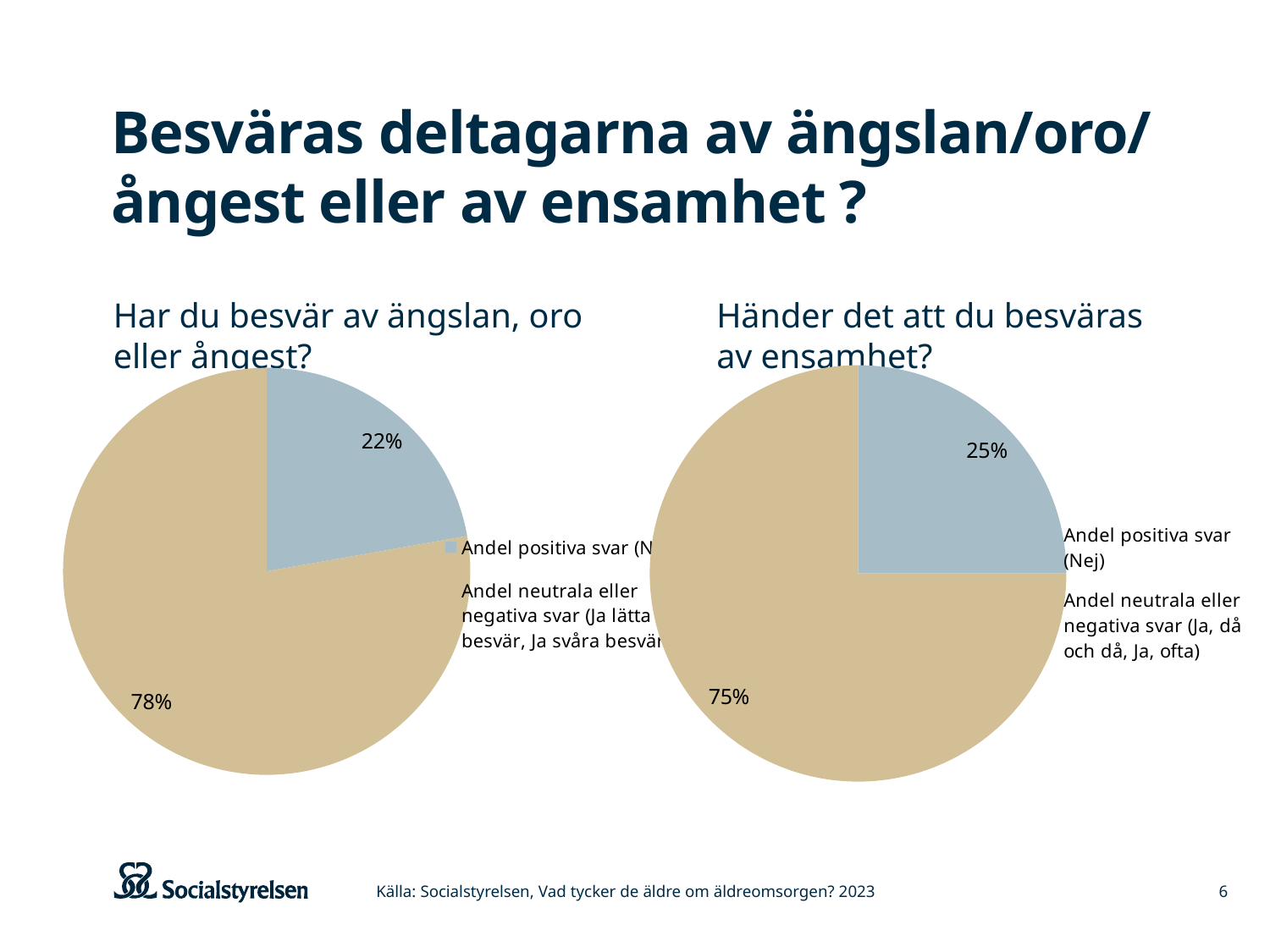
In the left pie chart ("Har du besvär av ängslan, oro eller ångest?"), which slice is the largest? Andel neutrala eller negativa svar (78%) In the left pie chart ("Har du besvär av ängslan, oro eller ångest?"), what share is labelled for the blue slice (Andel positiva svar)? 22% In the right pie chart ("Händer det att du besväras av ensamhet?"), which slice is the smallest? Andel positiva svar (Nej) (25%) In the left pie chart ("Har du besvär av ängslan, oro eller ångest?"), what is the difference in percentage points between the two slices? 56 percentage points In the left pie chart ("Har du besvär av ängslan, oro eller ångest?"), what share is labelled for the beige slice (Andel neutrala eller negativa svar)? 78% Which chart shows a larger share of positive answers: the left chart (ängslan, oro eller ångest) or the right chart (ensamhet)? The right chart (ensamhet), 25% In the right pie chart ("Händer det att du besväras av ensamhet?"), what is the difference in percentage points between the two slices? 50 percentage points How many slices does each pie chart on the slide have? 2 In the right pie chart ("Händer det att du besväras av ensamhet?"), what share is labelled for Andel positiva svar (Nej)? 25% In the right pie chart ("Händer det att du besväras av ensamhet?"), what colour is the slice for Andel positiva svar (Nej)? Blue (light blue-grey) In the right pie chart ("Händer det att du besväras av ensamhet?"), what share is labelled for Andel neutrala eller negativa svar? 75% What kind of chart is used on the left, titled "Har du besvär av ängslan, oro eller ångest?"? Pie chart